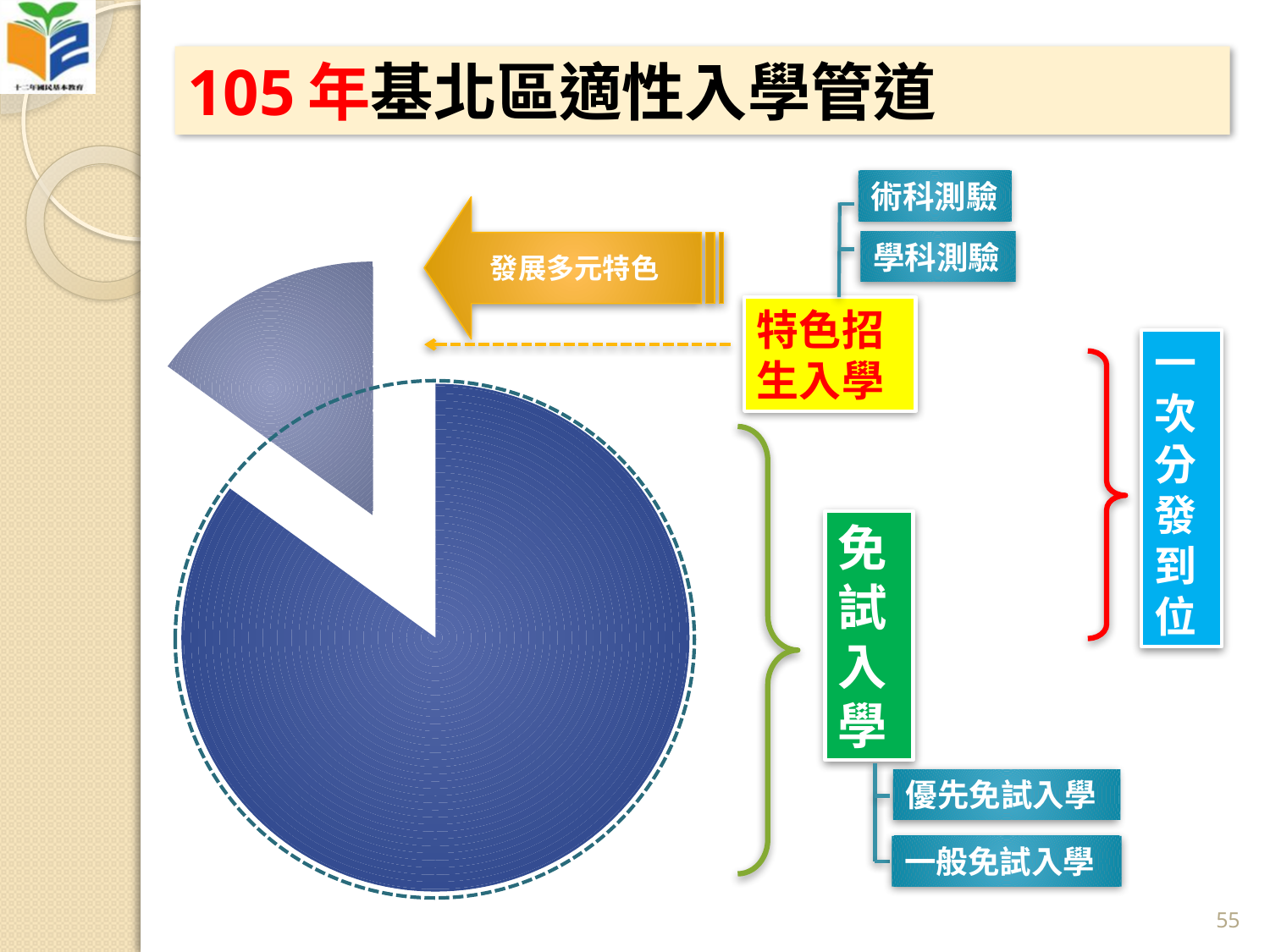
Is the share of the pie chart for 免試入學 greater or less than 50%? greater What colour is the large slice of the pie chart representing 免試入學? blue Which slice of the pie chart is larger, the one for 免試入學 or the one for 特色招生入學? 免試入學 Which admission channel does the smallest slice of the pie chart represent? 特色招生入學 How many slices does the pie chart have? 2 Which slice of the pie chart is pulled out (exploded) from the rest of the pie? 特色招生入學 Which admission channel does the largest slice of the pie chart represent? 免試入學 Is the share of the pie chart for 特色招生入學 greater or less than 25%? less What kind of chart is shown on the slide? pie chart